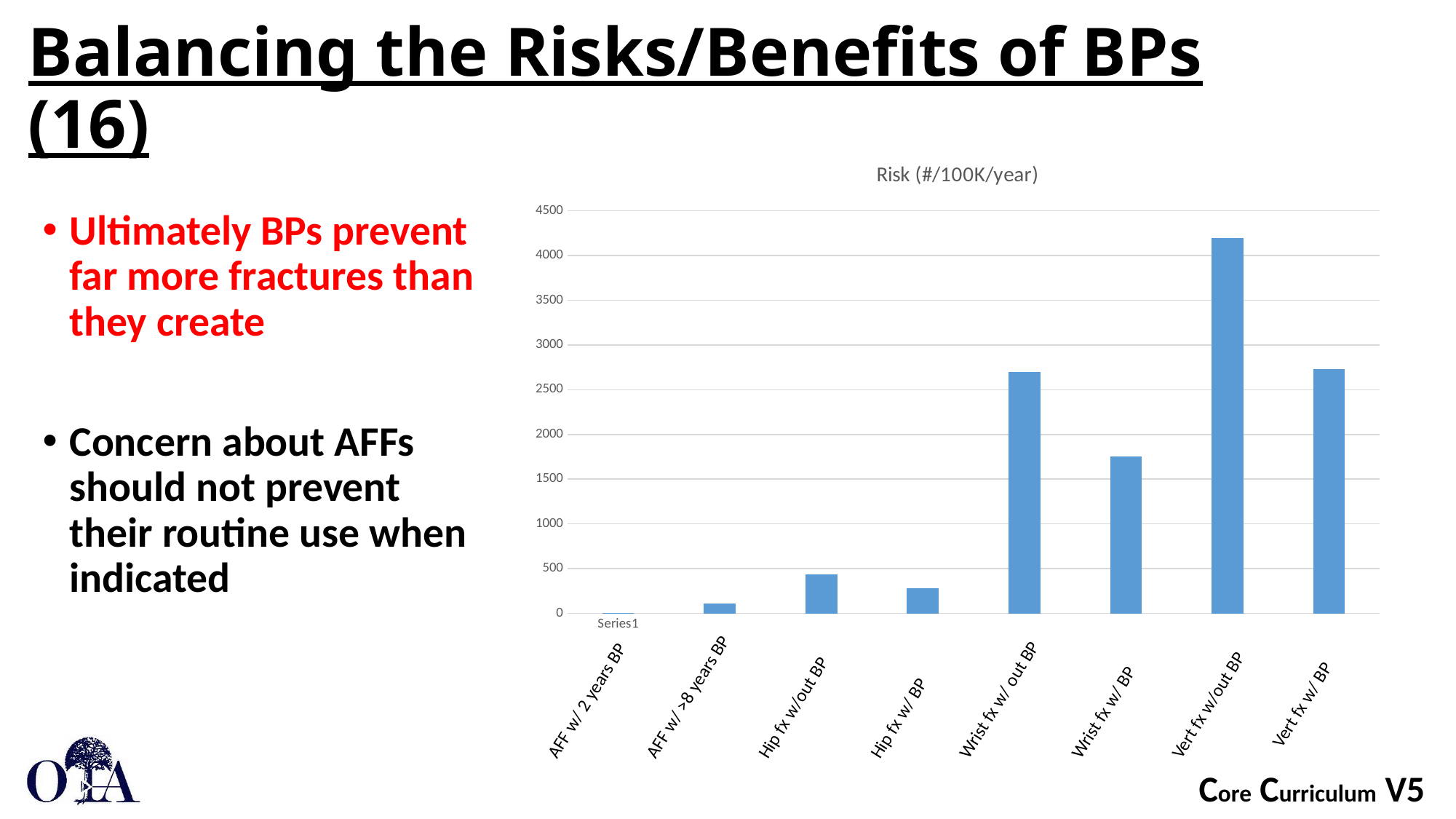
Which category has the lowest value on the chart? AFF w/ 2 years BP Is the value for AFF w/ >8 years BP greater or less than 500? less Which category has the highest value on the chart? Vert fx w/out BP Is the value for Wrist fx w/ out BP greater or less than 2500? greater How many categories are plotted on the chart? 8 Is the value for Hip fx w/out BP greater or less than 500? less What kind of chart is shown on the slide? bar chart What is the title of the chart? Risk (#/100K/year) Which is larger, the value for Hip fx w/out BP or the value for Hip fx w/ BP? Hip fx w/out BP Which is larger, the value for Wrist fx w/ out BP or the value for Wrist fx w/ BP? Wrist fx w/ out BP